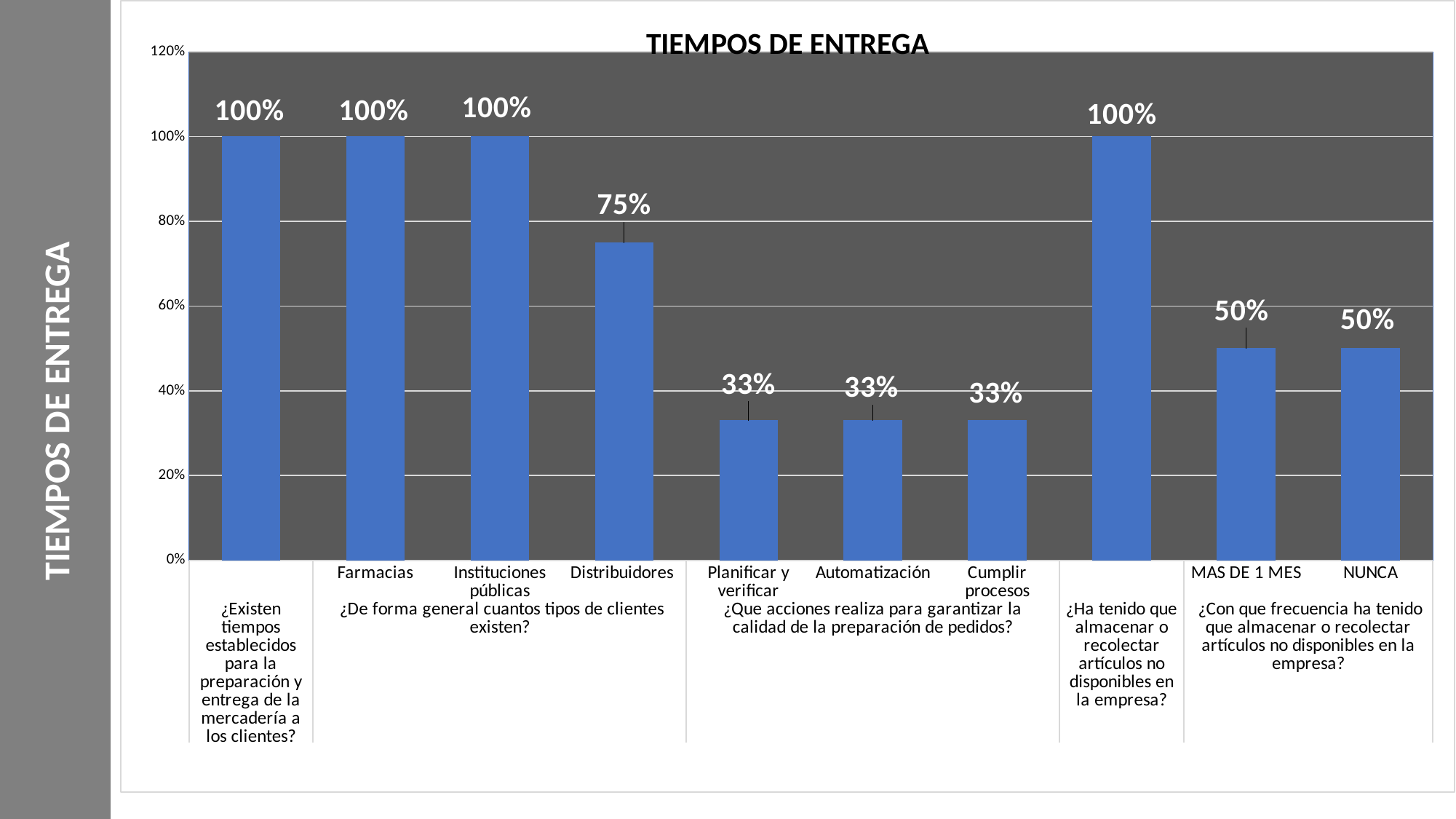
What is the value for Cumplir procesos? 33% What is the value for Distribuidores? 75% What is the value for Automatización? 33% What is the title of the chart? TIEMPOS DE ENTREGA Which is larger, the value for Distribuidores or the value for NUNCA? Distribuidores What is the difference between the values for Instituciones públicas and Planificar y verificar? 67% Is the value for Distribuidores greater or less than 60%? greater What is the value for Farmacias? 100% What is the difference between the values for Distribuidores and MAS DE 1 MES? 25% What kind of chart is shown on the slide? bar chart What is the value for NUNCA? 50% How many bars are plotted in the chart? 10